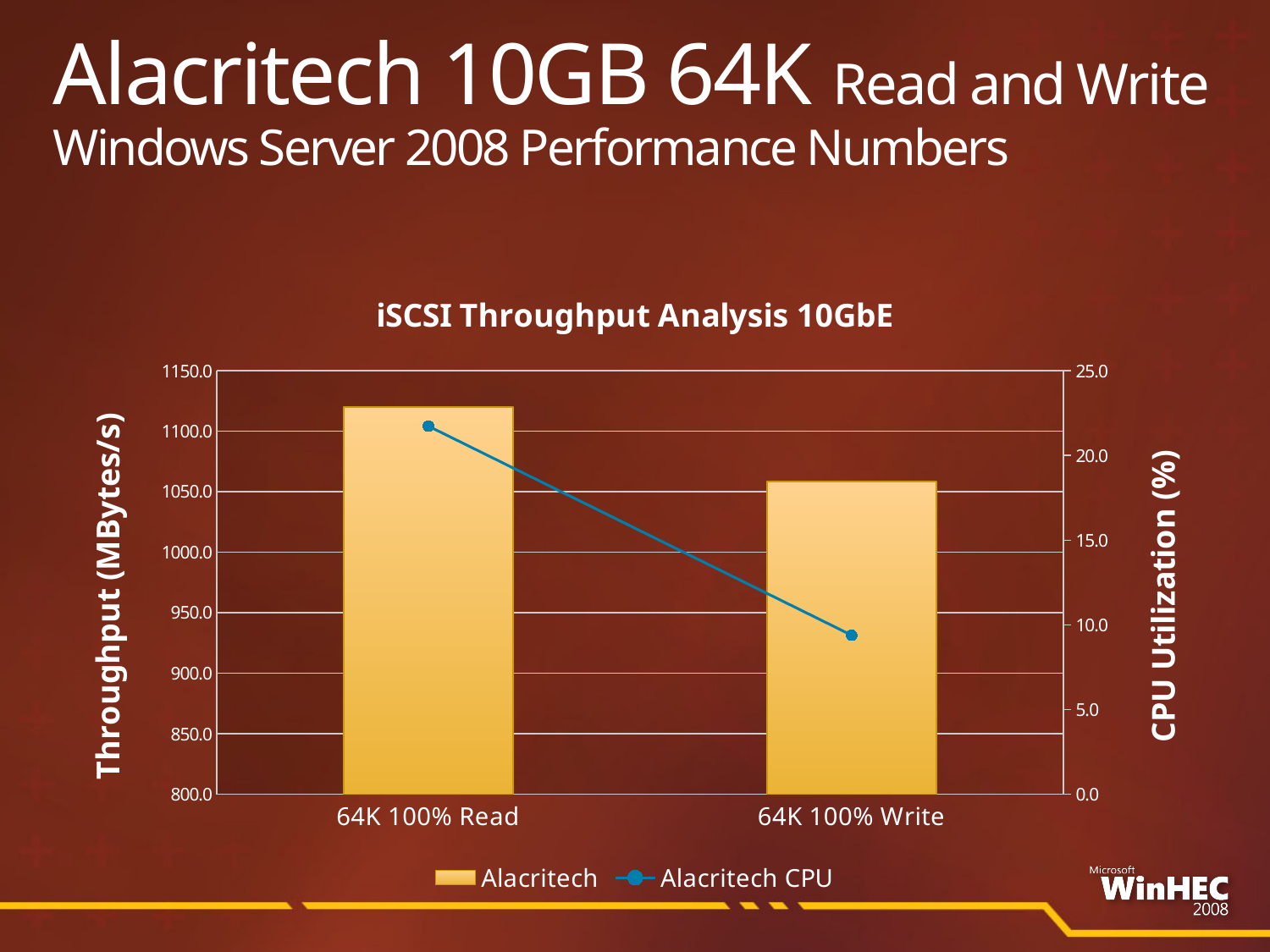
Is the Alacritech throughput for 64K 100% Read greater or less than 1100? greater What is the title of the chart? iSCSI Throughput Analysis 10GbE How many categories are shown on the x axis of the chart? 2 Is the Alacritech throughput for 64K 100% Write greater or less than 1100? less Which category has the lower Alacritech throughput bar? 64K 100% Write Is the Alacritech CPU utilization for 64K 100% Write greater or less than 15.0? less Which category has the higher Alacritech throughput bar? 64K 100% Read How many series does the chart's legend list? 2 Which category has the higher Alacritech CPU utilization, 64K 100% Read or 64K 100% Write? 64K 100% Read Does the Alacritech CPU line rise or fall from 64K 100% Read to 64K 100% Write? fall What kind of chart is shown on the slide? bar chart with a line